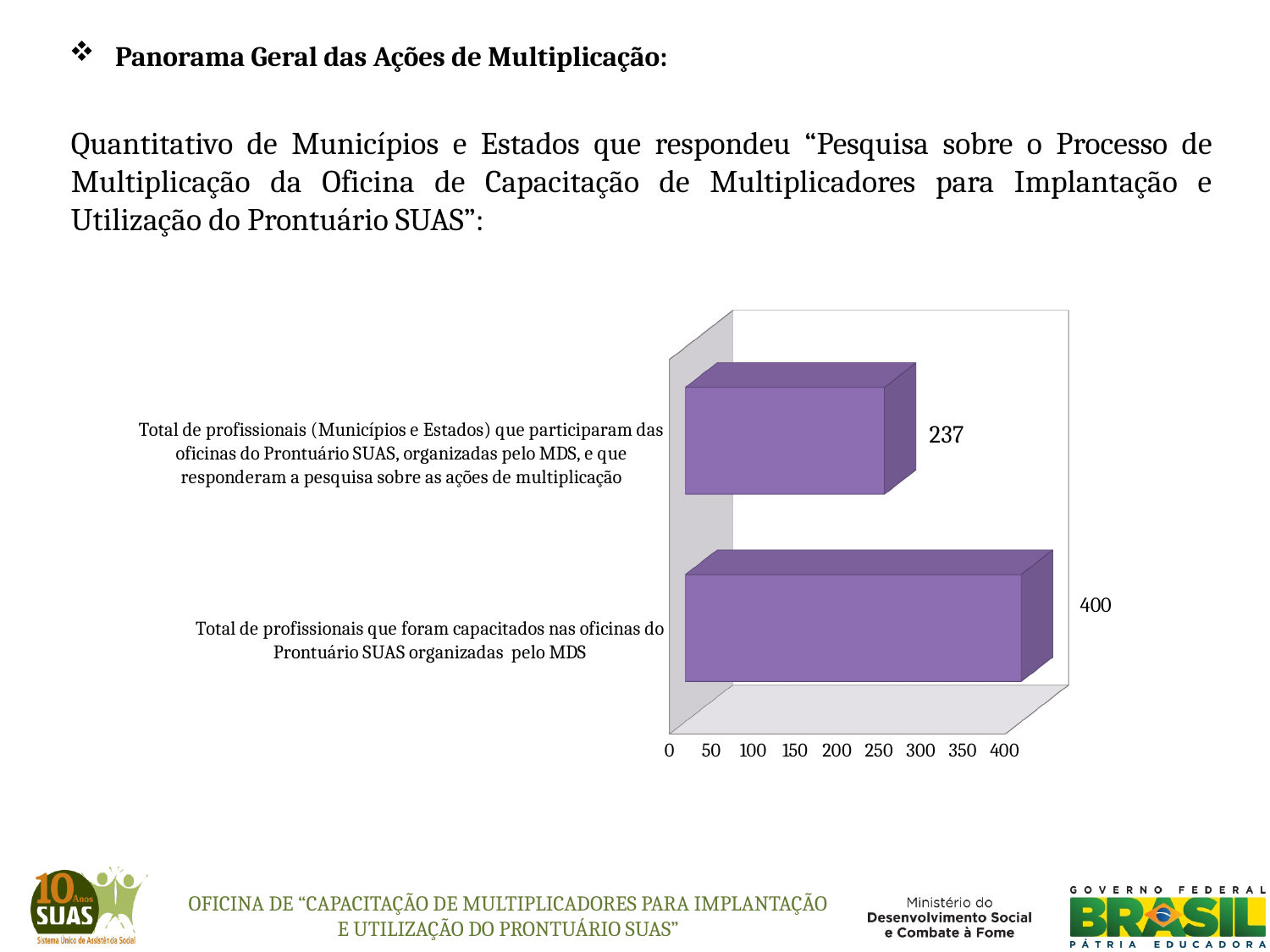
What is the value for the total of professionals who were trained (capacitados) in the Prontuário SUAS workshops organized by the MDS? 400 What colour are the bars in the chart? Purple What is the maximum value shown on the chart's value axis? 400 Is the value for professionals trained in the workshops greater or less than 350? greater Which category has the highest value in the chart? Total de profissionais que foram capacitados nas oficinas do Prontuário SUAS organizadas pelo MDS What kind of chart is shown on the slide? Bar chart How many categories are shown in the chart? 2 What is the difference between the number of professionals trained in the workshops and the number who responded to the survey? 163 What is the value for the total of professionals (Municípios e Estados) who participated in the workshops and responded to the survey on multiplication actions? 237 Which is larger: the number of professionals trained in the workshops or the number who responded to the survey? The number of professionals trained in the workshops (400) Which category has the lowest value in the chart? Total de profissionais (Municípios e Estados) que participaram das oficinas do Prontuário SUAS, organizadas pelo MDS, e que responderam a pesquisa sobre as ações de multiplicação Is the value for professionals who responded to the survey greater or less than 250? less